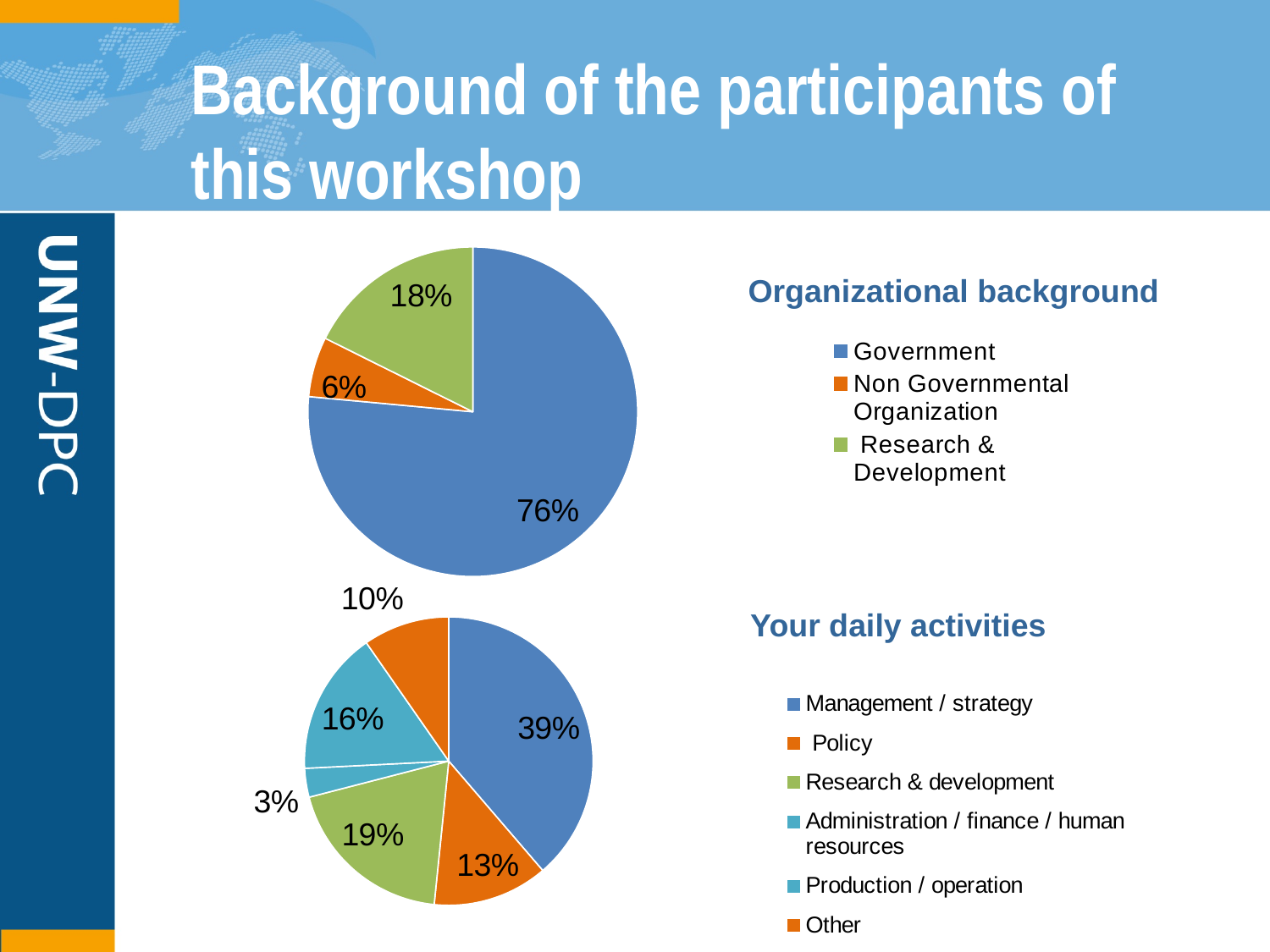
In the Organizational background chart, what percentage is Research & Development? 18% In the Organizational background chart, which category has the smallest share? Non Governmental Organization In the Your daily activities chart, what share is Administration / finance / human resources? 3% In the Your daily activities chart, how many categories does the legend list? 6 In the Your daily activities chart, what share is Research & development? 19% In the Organizational background chart, what is the difference between the Government share and the Research & Development share? 58 percentage points In the Your daily activities chart, which category has the largest share? Management / strategy In the Your daily activities chart, what share is Management / strategy? 39% In the Organizational background chart, what percentage is Non Governmental Organization? 6% In the Organizational background chart, how many categories does the legend list? 3 What type of chart is used for Your daily activities? Pie chart In the Organizational background chart, what share of participants are from Government? 76%